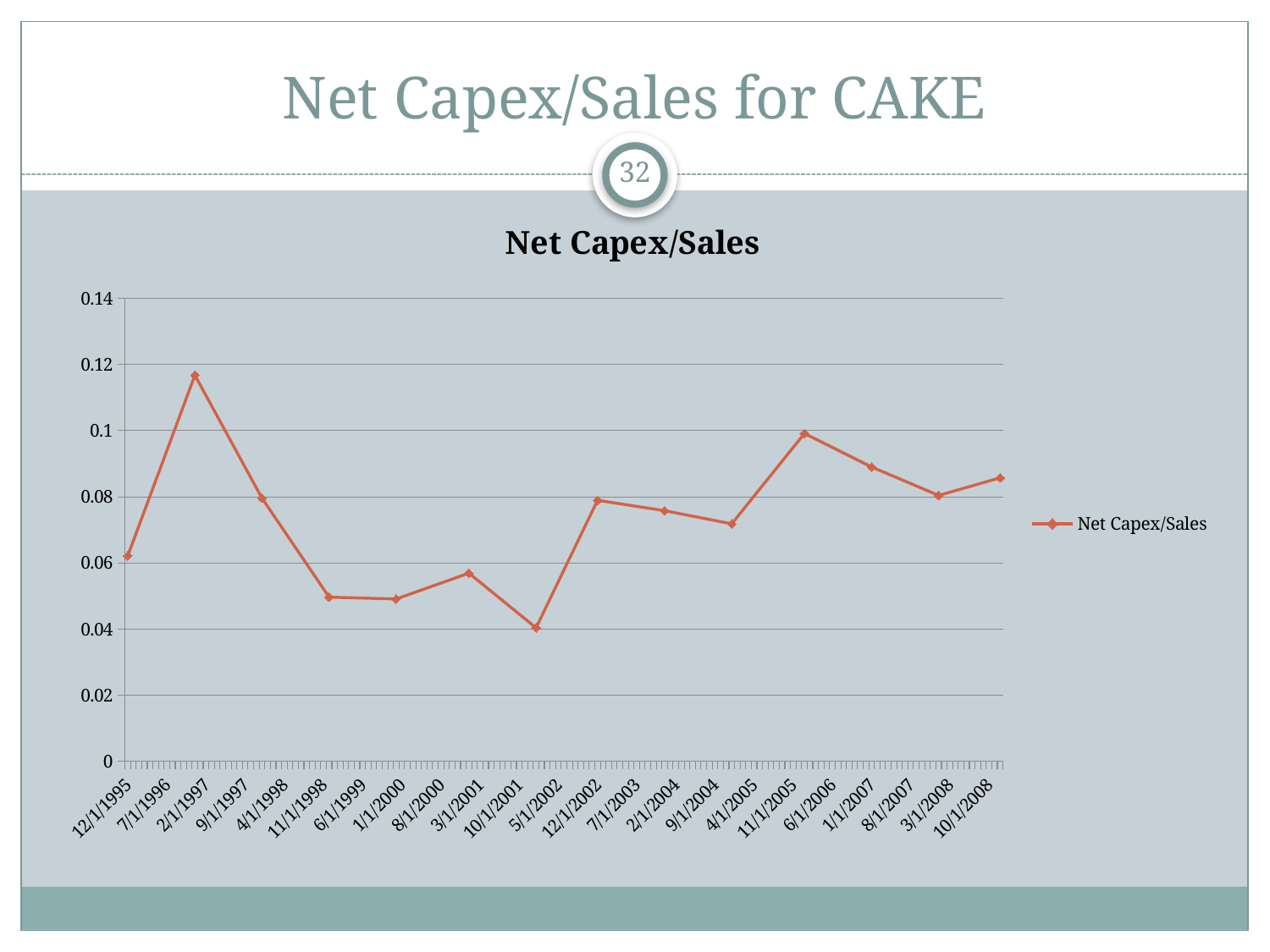
What is the title printed above the chart? Net Capex/Sales Does the line rise or fall between the second plotted point and the fourth plotted point? falls What is the name of the series shown in the legend? Net Capex/Sales What kind of chart is shown on the slide? line chart Which is larger, the first plotted value or the second plotted value? the second How many series does the legend list? 1 Which is larger, the first plotted value or the last plotted value? the last Is the highest plotted value greater or less than 0.1? greater How many data points are plotted on the line? 14 Is the lowest plotted value greater or less than 0.06? less Does the line rise or fall between the first and second plotted points? rises Is the last plotted value (at the right end of the line) greater or less than 0.08? greater